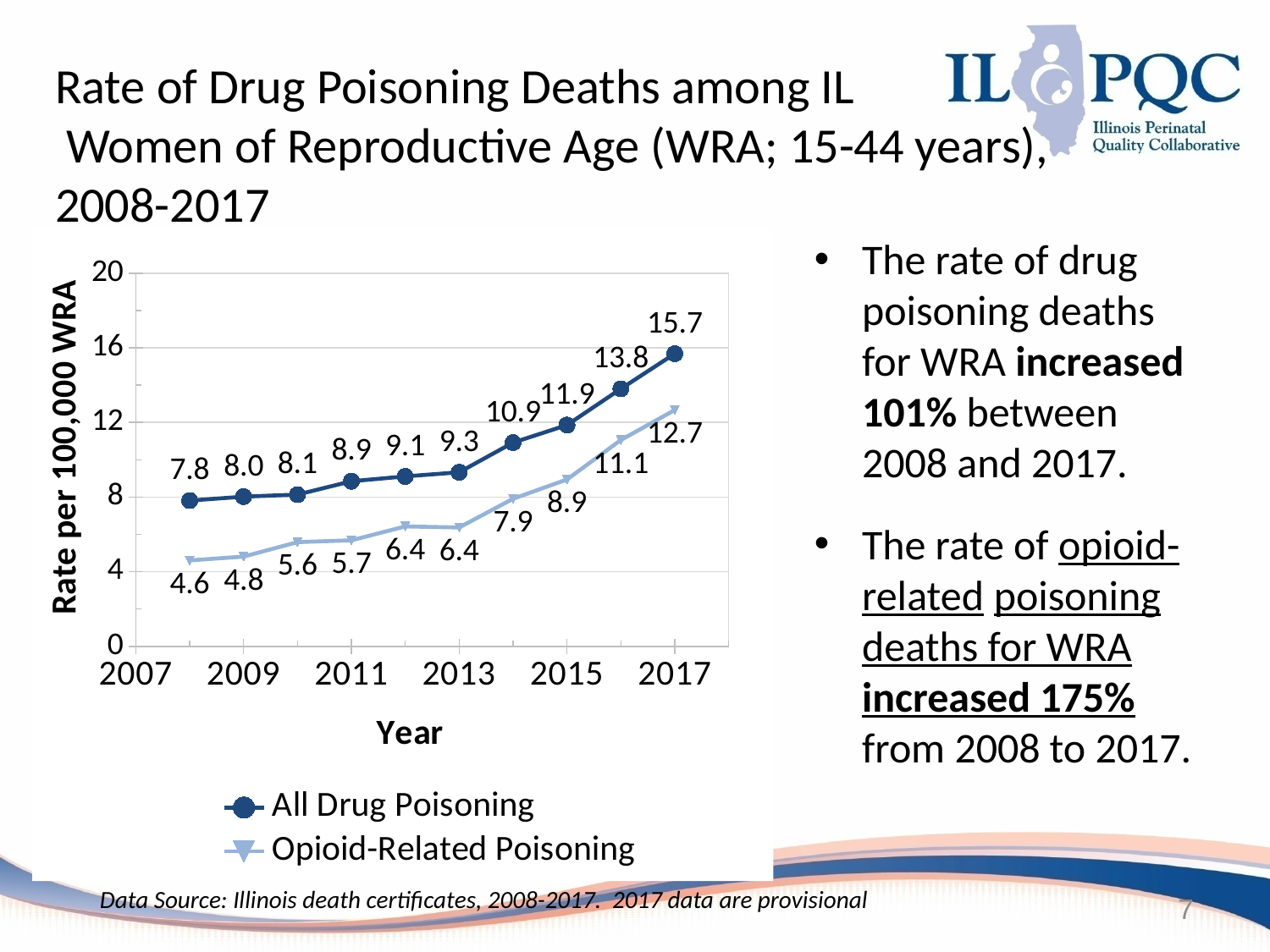
What type of chart is shown on the slide? Line chart Does the All Drug Poisoning rate rise or fall from 2008 to 2017? Rise In which year was the Opioid-Related Poisoning rate highest? 2017 What was the All Drug Poisoning rate per 100,000 WRA in 2017? 15.7 What is the difference between the All Drug Poisoning rate and the Opioid-Related Poisoning rate in 2017? 3.0 In which year was the All Drug Poisoning rate lowest? 2008 How many series does the legend list? 2 Is the Opioid-Related Poisoning rate in 2016 greater or less than 8? greater Which series had the higher rate in 2016, All Drug Poisoning or Opioid-Related Poisoning? All Drug Poisoning What was the Opioid-Related Poisoning rate per 100,000 WRA in 2008? 4.6 What was the All Drug Poisoning rate in 2014? 10.9 How many years of data are plotted for each series? 10